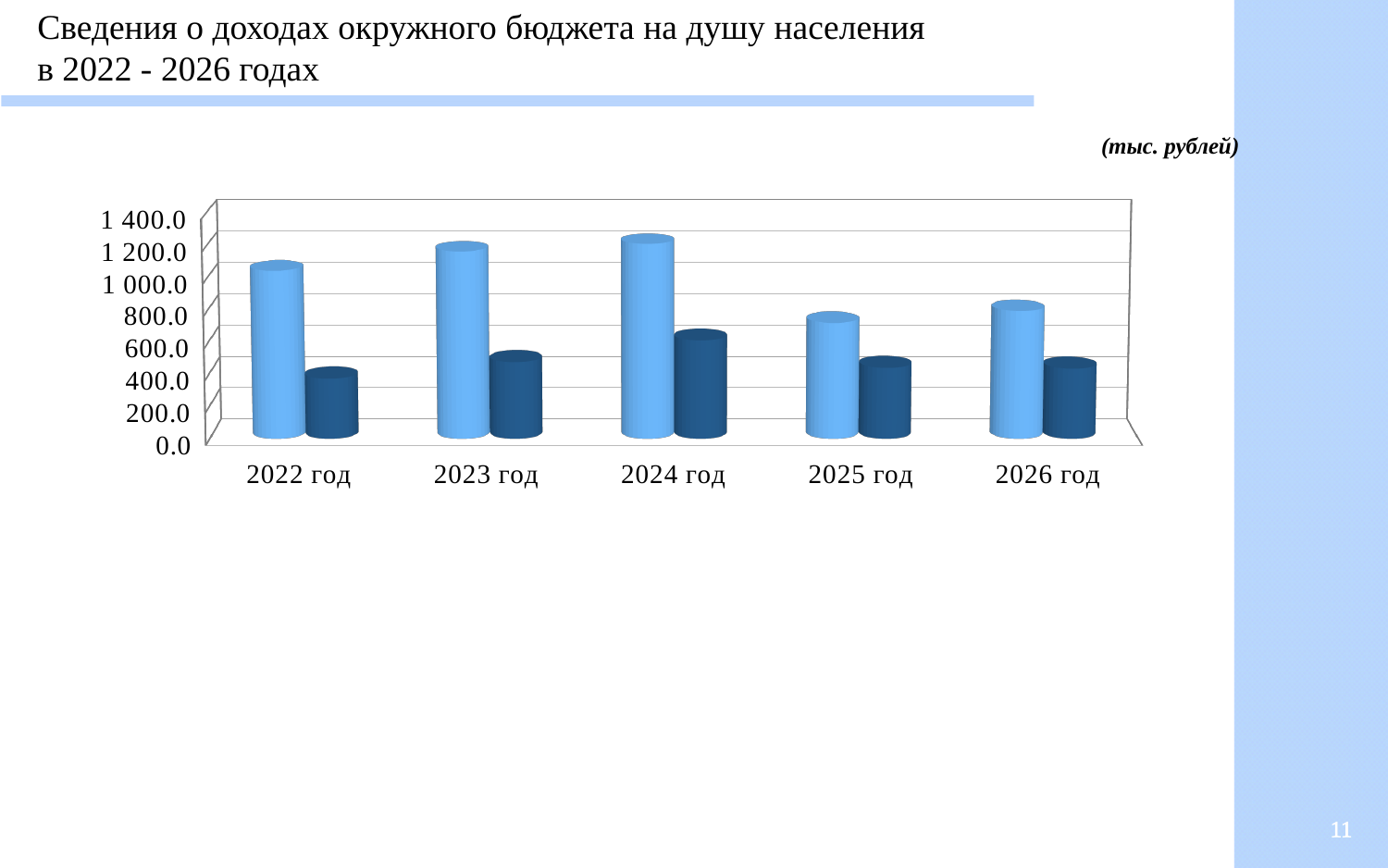
In which year is the dark blue bar the tallest? 2024 год How many bars are shown for each year in the chart? 2 Is the value of the dark blue bar for 2022 год greater or less than 600.0? less In which year is the dark blue bar the shortest? 2022 год In which year is the light blue bar the shortest? 2025 год Is the value of the light blue bar for 2025 год greater or less than 1 000.0? less In which year is the light blue bar the tallest? 2024 год How many year categories are shown on the x axis of the chart? 5 What unit is indicated for the values in the chart? (тыс. рублей) Which is larger for 2022 год: the light blue bar or the dark blue bar? the light blue bar Is the value of the light blue bar for 2024 год greater or less than 1 000.0? greater What kind of chart is shown on the slide? bar chart